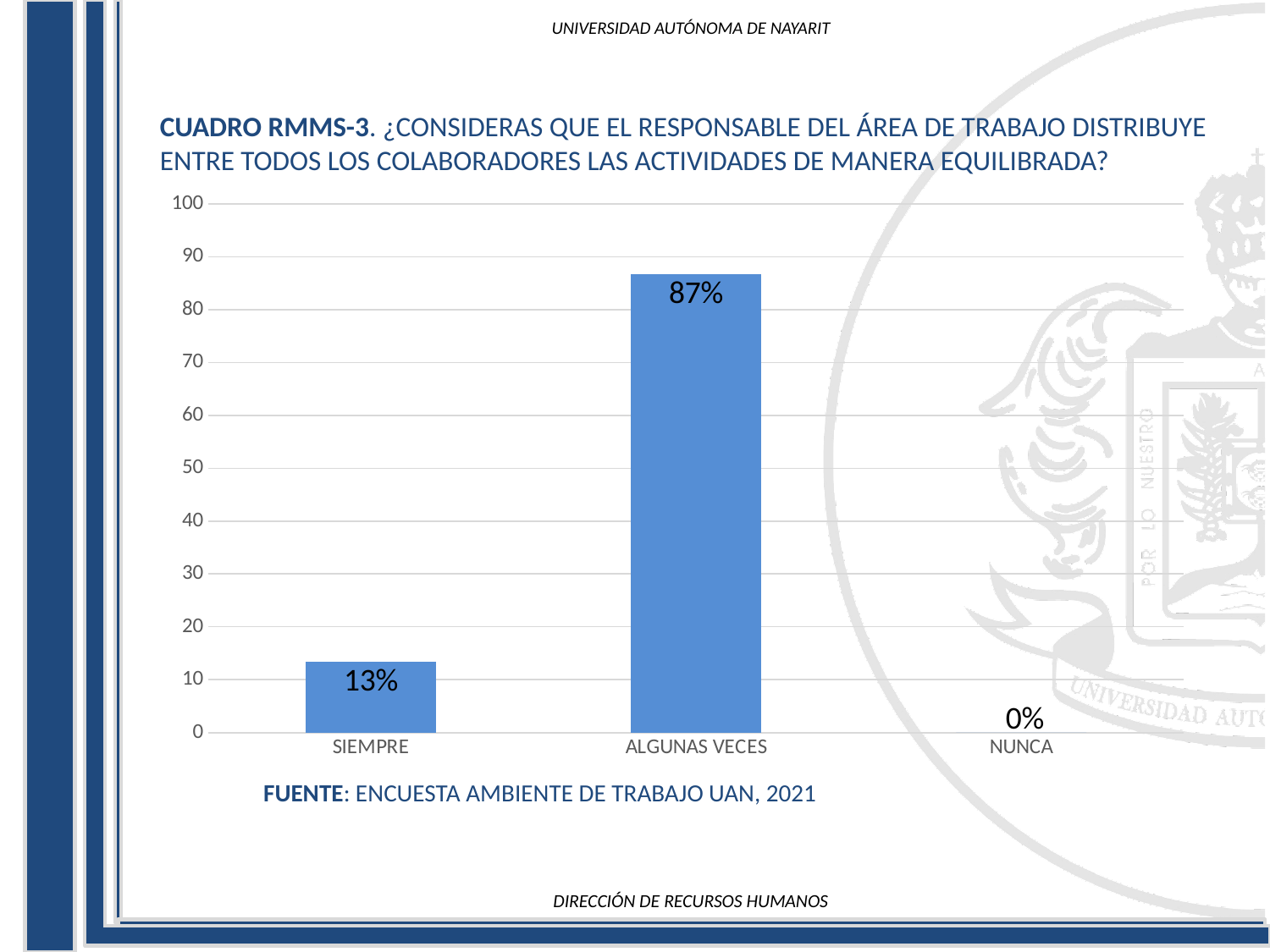
Which category has the lowest value? NUNCA Is the value for SIEMPRE greater or less than 20? less How many categories are shown on the x axis? 3 Is the value for ALGUNAS VECES greater or less than 80? greater What is the difference between the values for ALGUNAS VECES and SIEMPRE? 74% What kind of chart is shown on the slide? bar chart What is the value for NUNCA? 0% Which category has the highest value? ALGUNAS VECES What is the value for SIEMPRE? 13% Which is larger, the value for SIEMPRE or the value for NUNCA? SIEMPRE What is the value for ALGUNAS VECES? 87% What source is cited below the chart? ENCUESTA AMBIENTE DE TRABAJO UAN, 2021